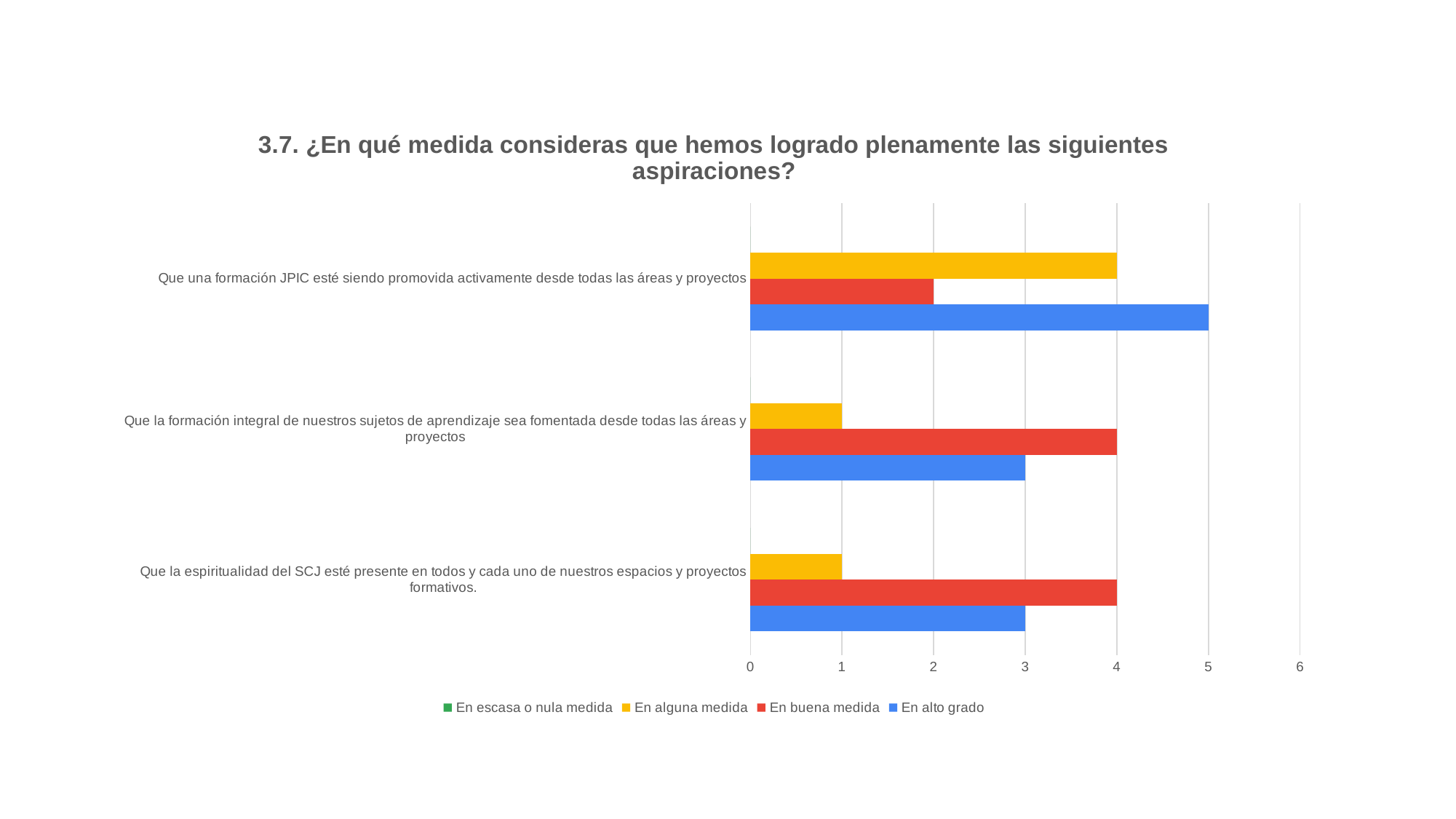
For "Que la formación integral de nuestros sujetos de aprendizaje sea fomentada desde todas las áreas y proyectos", which is larger: "En buena medida" or "En alto grado"? En buena medida Which category has the lowest value for "En buena medida"? Que una formación JPIC esté siendo promovida activamente desde todas las áreas y proyectos What is the value of "En buena medida" for "Que una formación JPIC esté siendo promovida activamente desde todas las áreas y proyectos"? 2 How many categories (aspirations) are plotted on the chart? 3 What is the value of "En alto grado" for "Que una formación JPIC esté siendo promovida activamente desde todas las áreas y proyectos"? 5 Which legend series has no visible bars on the chart? En escasa o nula medida How many series does the legend list? 4 Which category has the highest value for "En alto grado"? Que una formación JPIC esté siendo promovida activamente desde todas las áreas y proyectos What is the difference between "En alto grado" and "En buena medida" for "Que una formación JPIC esté siendo promovida activamente desde todas las áreas y proyectos"? 3 What kind of chart is shown on the slide? Bar chart What is the value of "En buena medida" for "Que la espiritualidad del SCJ esté presente en todos y cada uno de nuestros espacios y proyectos formativos."? 4 What is the value of "En alguna medida" for "Que la formación integral de nuestros sujetos de aprendizaje sea fomentada desde todas las áreas y proyectos"? 1